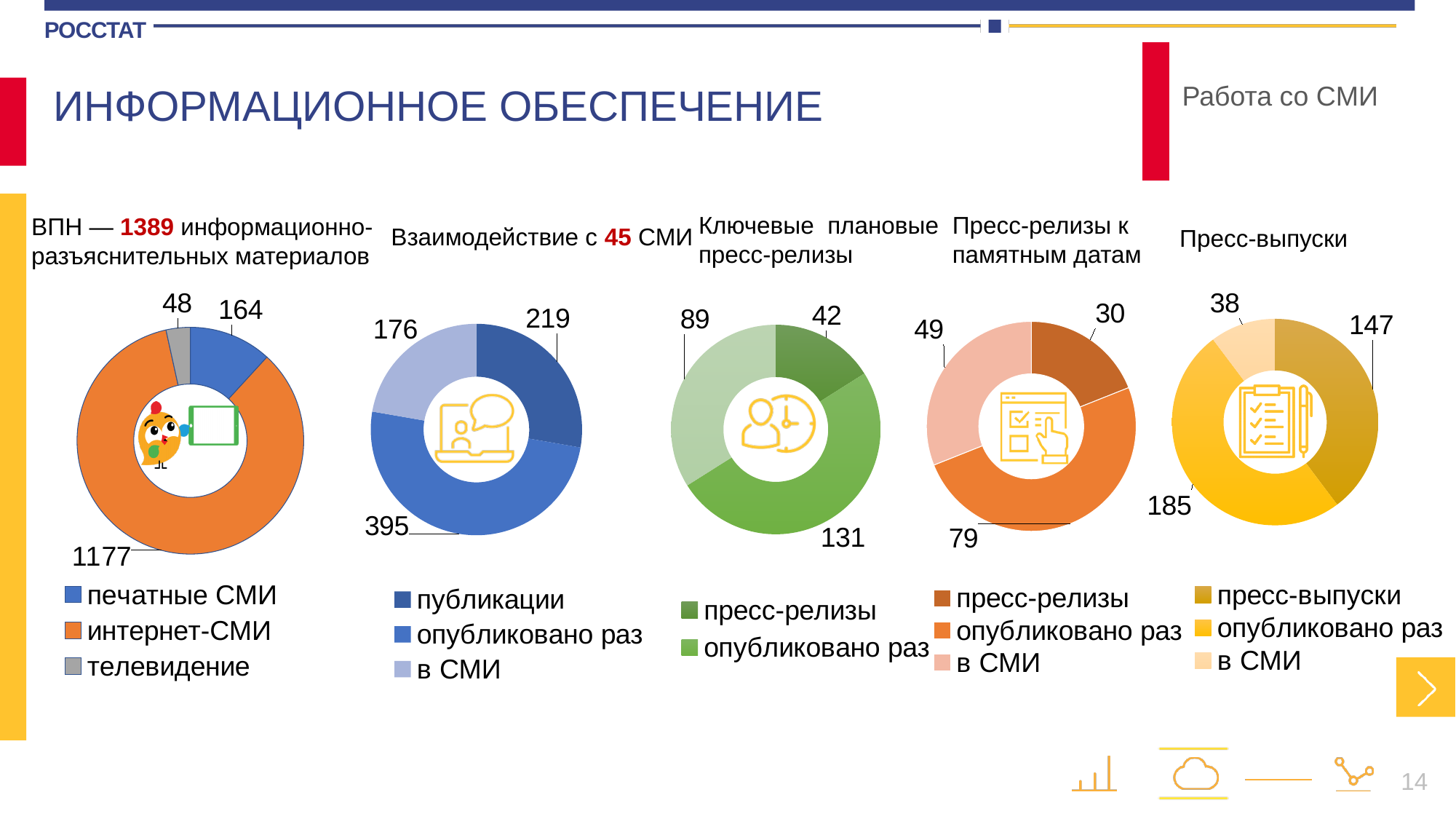
In the chart titled "Пресс-выпуски", what is the value for пресс-выпуски? 147 In the chart titled "ВПН — 1389 информационно-разъяснительных материалов", which category has the lowest value? телевидение What kind of chart is the chart titled "Пресс-выпуски"? Donut (pie) chart In the chart titled "Пресс-релизы к памятным датам", which is larger: опубликовано раз or пресс-релизы? опубликовано раз In the chart titled "Взаимодействие с 45 СМИ", how many entries does the legend list? 3 In the chart titled "Взаимодействие с 45 СМИ", what is the value for публикации? 219 In the chart titled "ВПН — 1389 информационно-разъяснительных материалов", what is the value for интернет-СМИ? 1177 In the chart titled "ВПН — 1389 информационно-разъяснительных материалов", what is the difference between печатные СМИ and телевидение? 116 In the chart titled "Ключевые плановые пресс-релизы", how many slices does the chart have? 3 In the chart titled "Пресс-релизы к памятным датам", what is the value for в СМИ? 49 In the chart titled "Ключевые плановые пресс-релизы", what is the value for опубликовано раз? 131 In the chart titled "Взаимодействие с 45 СМИ", which category has the highest value? опубликовано раз